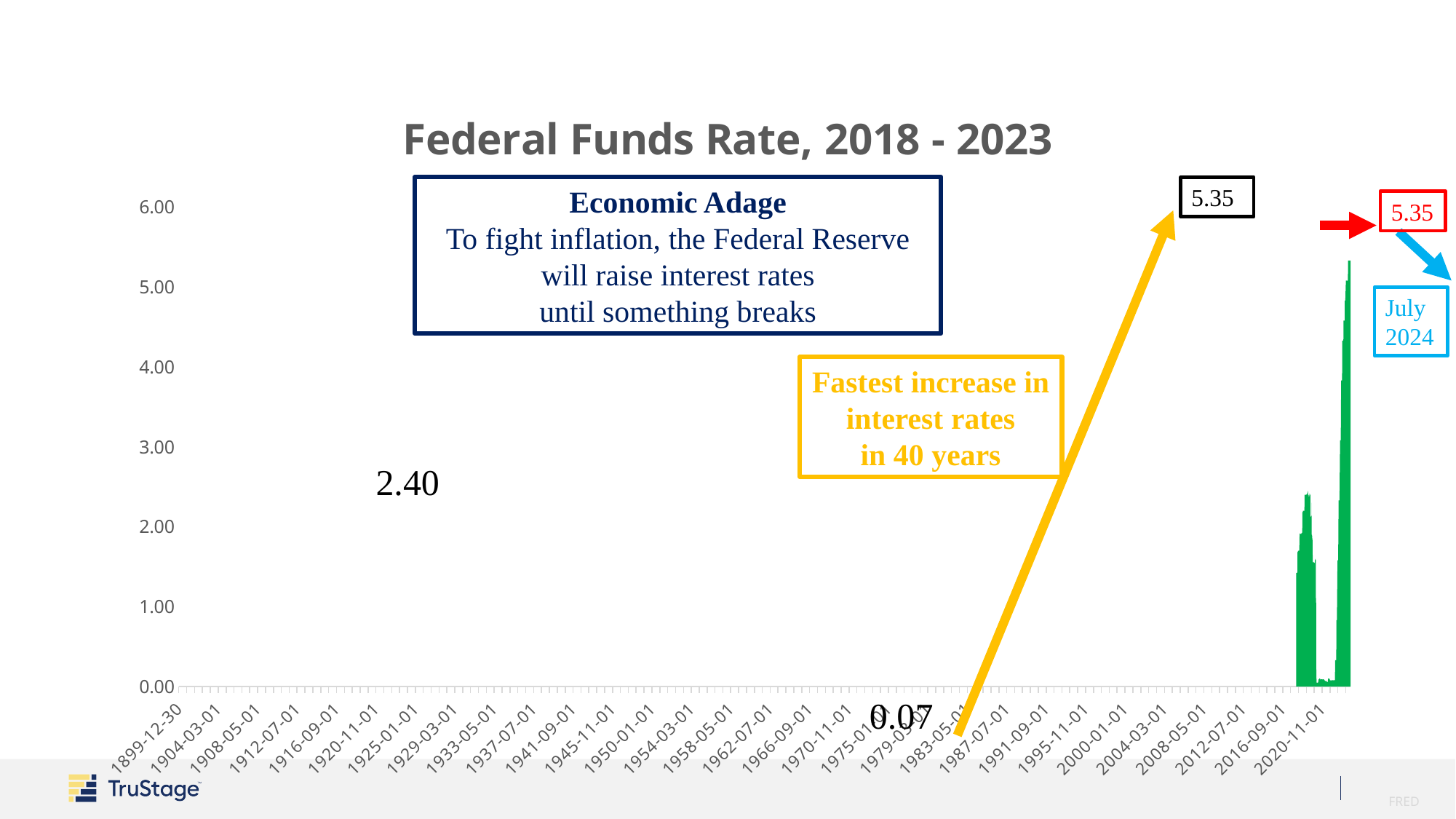
Which labeled value is larger, the later peak of 5.35 or the earlier peak of 2.40? 5.35 What value is labeled for the earlier, smaller peak of the Federal Funds Rate on the chart? 2.40 What value is given for the Federal Funds Rate in July 2024 according to the annotation? 5.35 What is the difference between the labeled peak value 5.35 and the labeled low value 0.07? 5.28 Does the Federal Funds Rate rise or fall in the final segment of the chart leading up to the 5.35 peak? rise Is the most recent peak of the Federal Funds Rate greater or less than 5.00? greater What is the lowest value labeled on the chart for the Federal Funds Rate? 0.07 What is the title of the chart? Federal Funds Rate, 2018 - 2023 What is the highest value shown on the vertical axis? 6.00 What is the highest value labeled on the chart for the Federal Funds Rate? 5.35 What is the difference between the labeled values 5.35 and 2.40? 2.95 Is the earlier peak of the Federal Funds Rate (around 2019) greater or less than 3.00? less